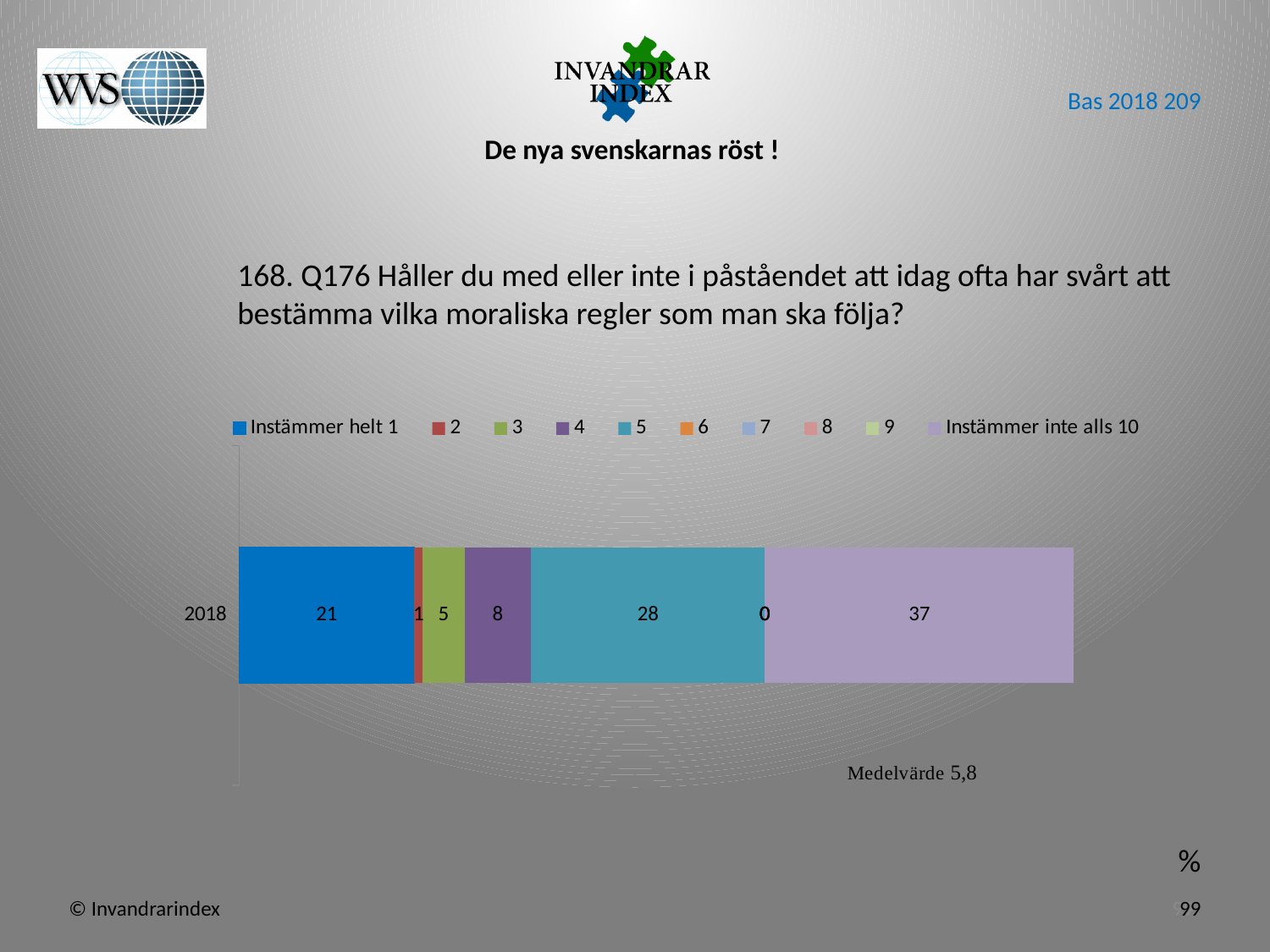
What is the difference between the values for 'Instämmer inte alls 10' and 'Instämmer helt 1'? 16 Which is larger, the value for series 5 or the value for 'Instämmer helt 1'? Series 5 How many categories (years) are plotted on the y axis? 1 What is the value for 'Instämmer inte alls 10' in 2018? 37 What is the value for series 4 in 2018? 8 How many series does the legend list? 10 What is the value for series 5 in 2018? 28 What kind of chart is shown on the slide? Stacked bar chart What is the value for 'Instämmer helt 1' in 2018? 21 What is the value for series 3 in 2018? 5 What mean value (Medelvärde) is shown below the chart? 5,8 Which series has the largest segment in the 2018 bar? Instämmer inte alls 10